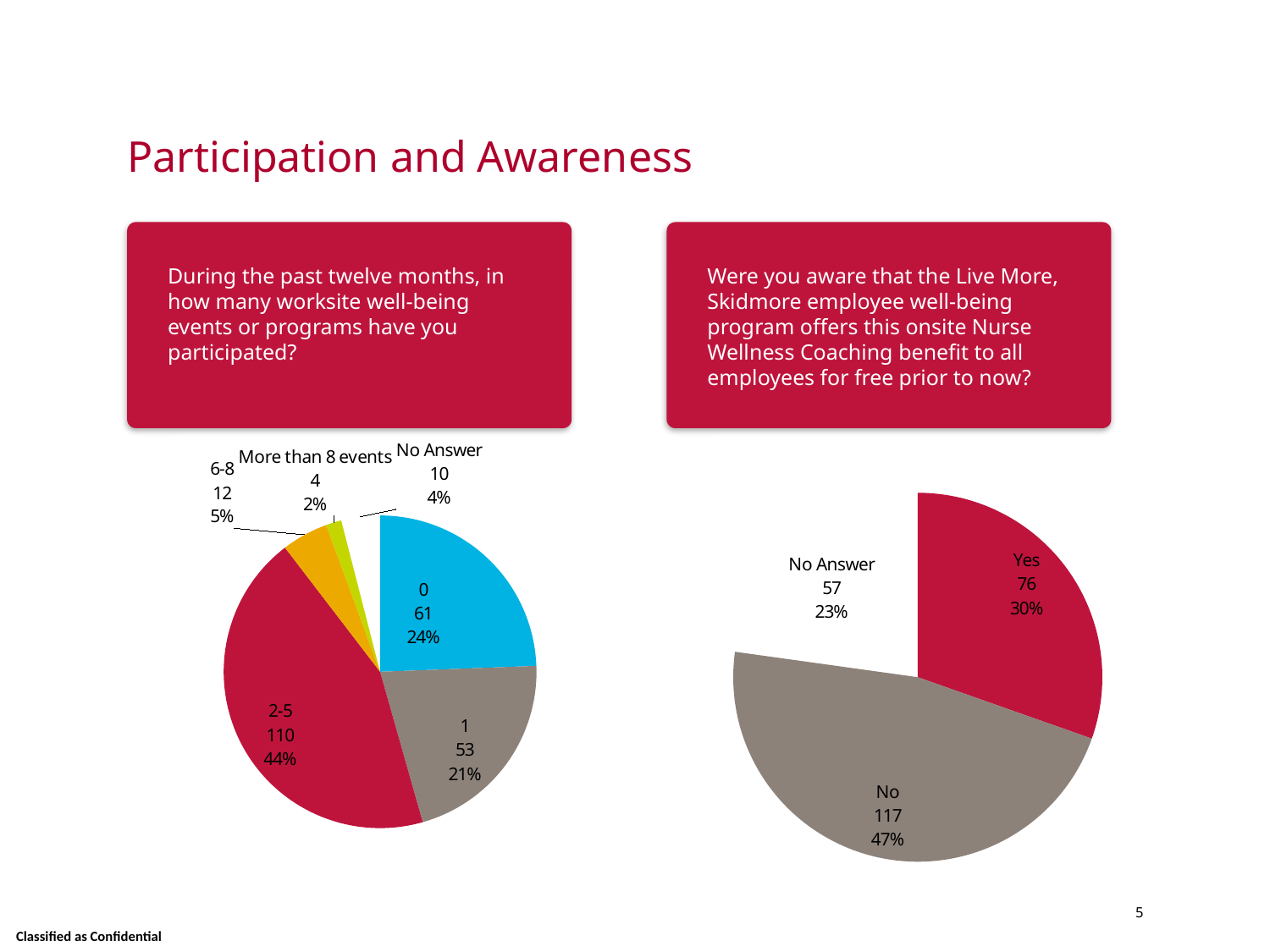
In the left pie chart, what percentage of respondents participated in 0 events? 24% In the left pie chart, which category has the smallest slice? More than 8 events In the left pie chart, what share of the pie does the 6-8 category represent? 5% What type of chart is shown on the right side of the slide? Pie chart In the right pie chart, what is the difference between the number of No responses and Yes responses? 41 In the left pie chart, how many categories are shown? 6 In the left pie chart, which category has the largest slice? 2-5 In the right pie chart, what share of respondents answered Yes? 30% In the right pie chart, which is larger: the Yes slice or the No Answer slice? Yes In the left pie chart, what is the difference between the number of respondents who participated in 0 events and those who participated in 1 event? 8 In the right pie chart, how many respondents answered No? 117 In the left pie chart, how many respondents participated in 2-5 events? 110